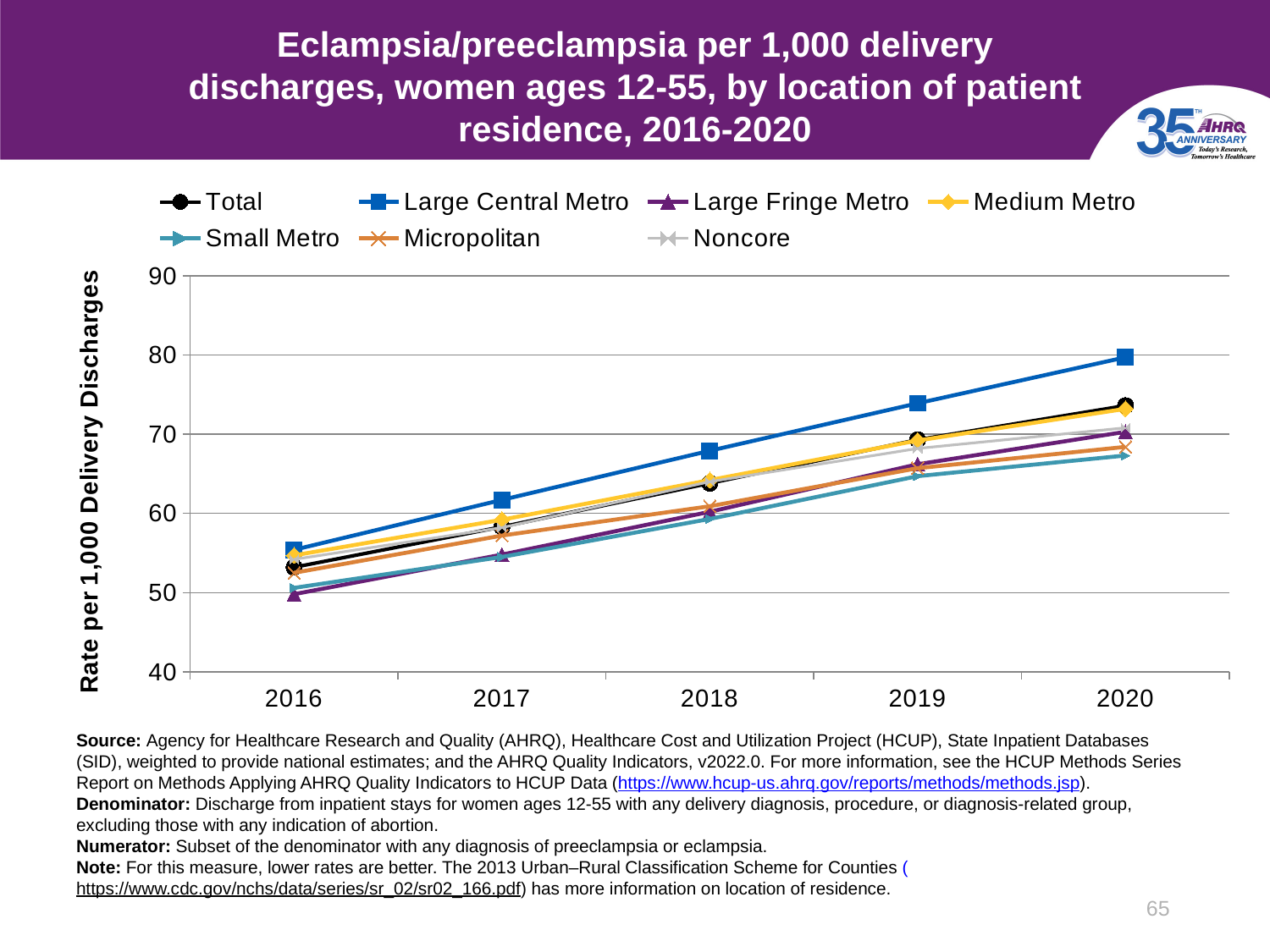
Is the value for Large Central Metro in 2019 greater or less than 70? greater Is the Total value in 2020 greater or less than 70? greater How many series does the legend list? 7 What kind of chart is shown on the slide? line chart Is the value for Large Central Metro in 2018 greater or less than 70? less Does the Total rate rise or fall over the period 2016-2020? rise Does the rate for Large Central Metro rise or fall from 2016 to 2020? rise What is the label of the y axis? Rate per 1,000 Delivery Discharges Which series has the highest rate in 2016? Large Central Metro How many years are plotted along the x axis? 5 Which is larger in 2020, the rate for Large Central Metro or the rate for Total? Large Central Metro Which location of patient residence has the highest rate in 2020? Large Central Metro